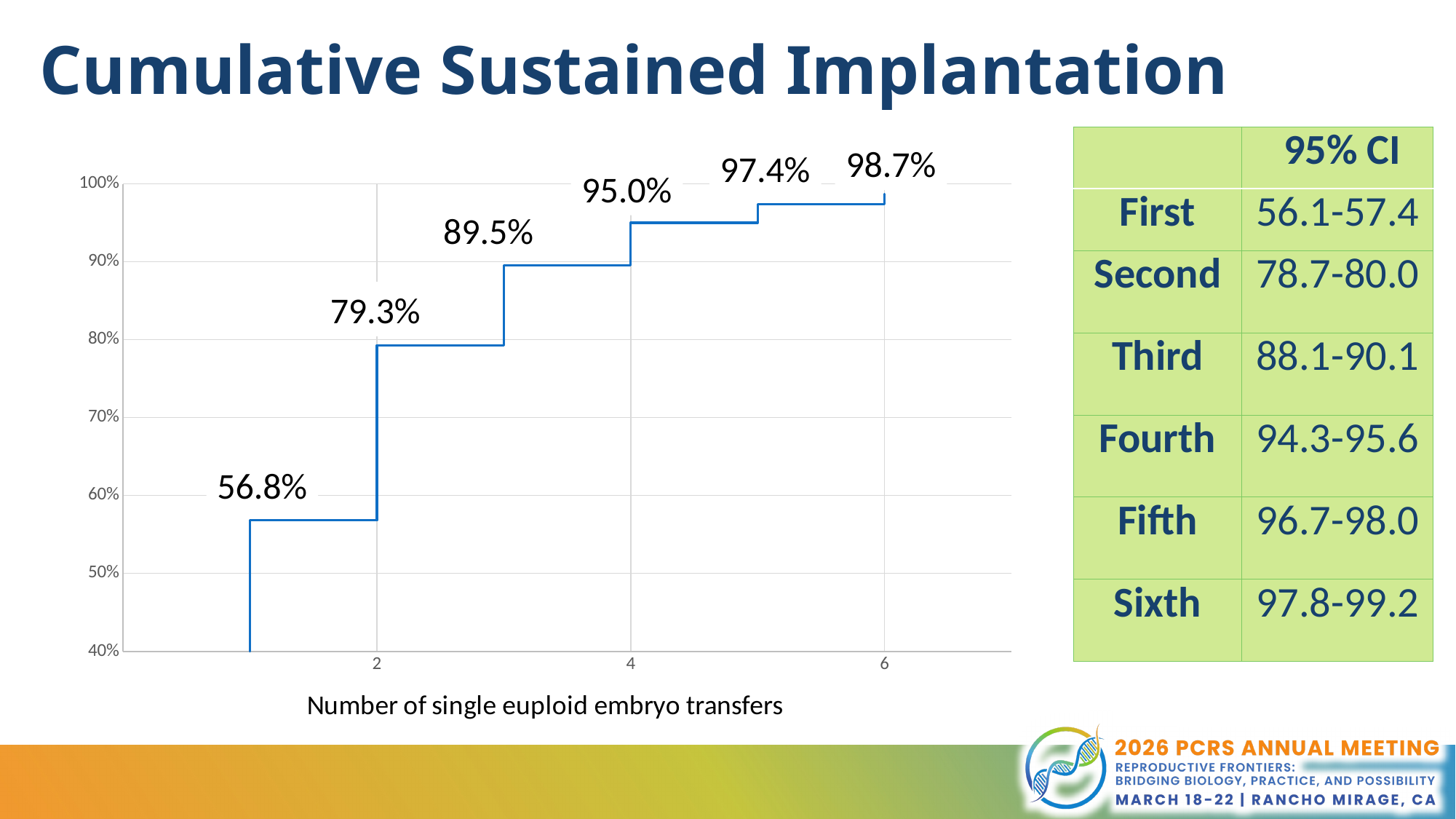
What is the cumulative sustained implantation rate after 4 single euploid embryo transfers? 95.0% Which number of transfers has the highest cumulative sustained implantation rate? 6 Do the cumulative sustained implantation values rise or fall as the number of transfers increases? Rise How many data points are labelled on the chart? 6 What is the cumulative sustained implantation rate after 1 single euploid embryo transfer? 56.8% Is the cumulative rate after 3 transfers greater or less than 90%? less What is the difference between the cumulative rate after 2 transfers and after 1 transfer? 22.5% What is the difference between the cumulative rate after 3 transfers and after 2 transfers? 10.2% What kind of chart is shown on the slide? Line chart (step line) What is the cumulative sustained implantation rate after 2 single euploid embryo transfers? 79.3% Which number of transfers has the lowest cumulative sustained implantation rate? 1 What is the cumulative sustained implantation rate after 6 single euploid embryo transfers? 98.7%